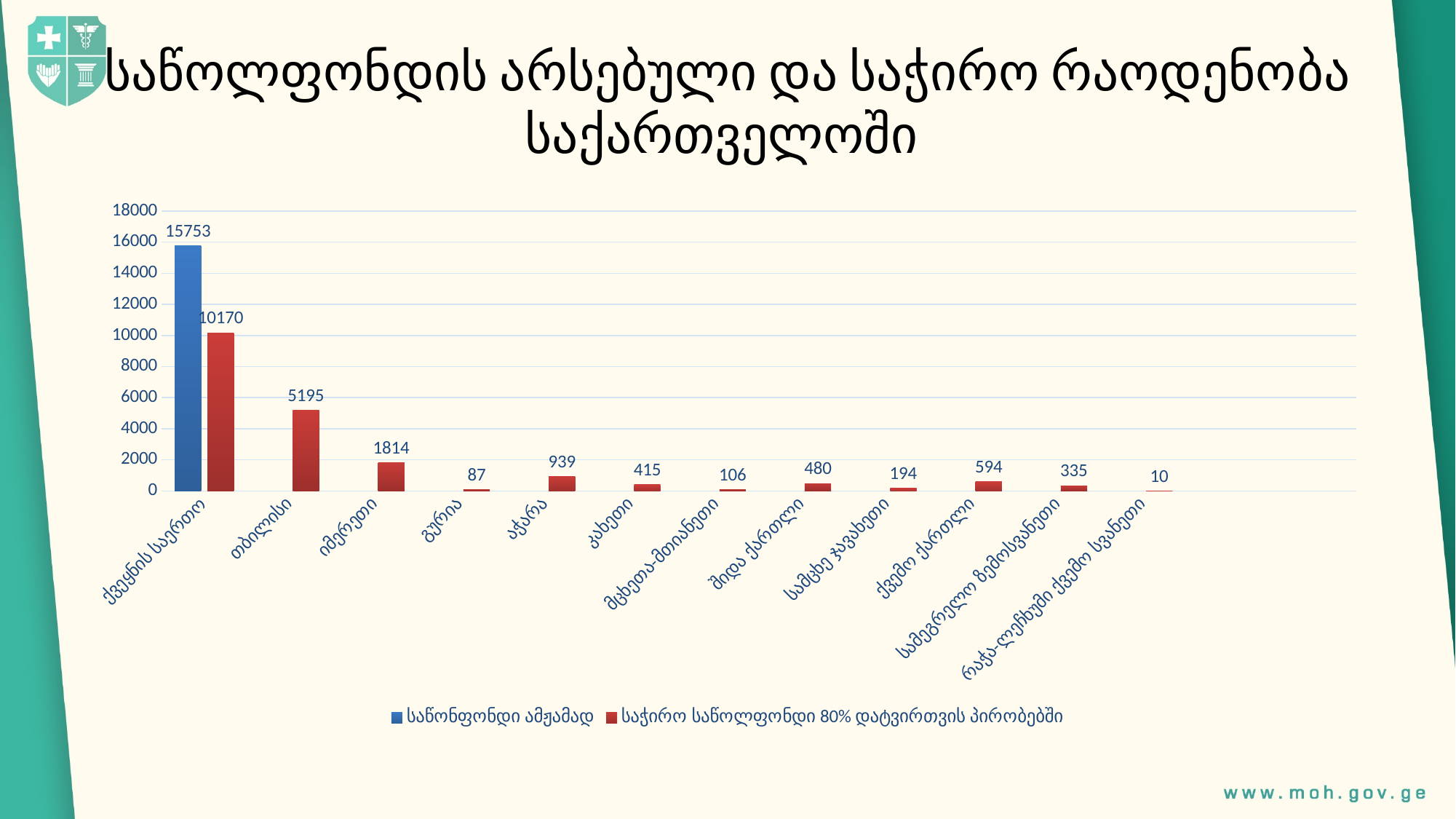
What is the value of the blue bar (საწონფონდი ამჟამად) for ქვეყნის საერთო? 15753 What is the value of the red bar for აჭარა? 939 What is the value of the red bar (საჭირო საწოლფონდი 80% დატვირთვის პირობებში) for თბილისი? 5195 Which is larger: the red bar for ქვემო ქართლი or the red bar for შიდა ქართლი? ქვემო ქართლი What type of chart is shown on the slide? bar chart What is the difference between the blue bar and the red bar for ქვეყნის საერთო? 5583 How many categories are shown on the x axis? 12 What is the value of the red bar for რაჭა-ლეჩხუმი ქვემო სვანეთი? 10 Which region (excluding ქვეყნის საერთო) has the highest red bar value? თბილისი How many series does the legend list? 2 Which region (excluding ქვეყნის საერთო) has the lowest red bar value? რაჭა-ლეჩხუმი ქვემო სვანეთი What is the difference between the red bar values for იმერეთი and კახეთი? 1399